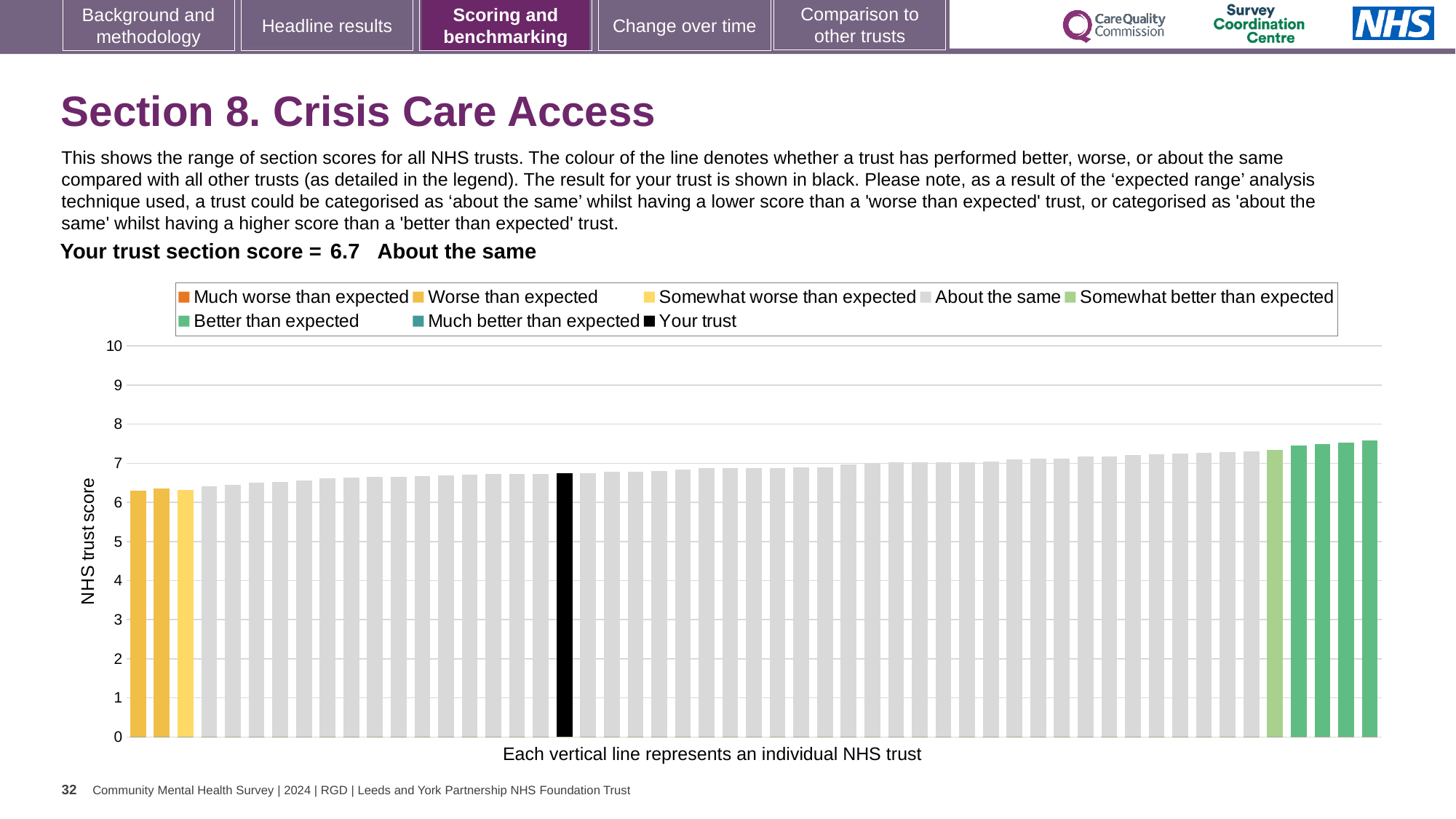
Is the value for the tallest bar on the chart greater or less than 7? greater How many entries does the chart legend list? 8 What is the label on the vertical axis of the chart? NHS trust score Is the value for the shortest bar on the chart greater or less than 6? greater What kind of chart is shown on the slide? bar chart Is the value for your trust (the black bar) greater or less than 7? less What is the section score for your trust shown on the slide? 6.7 How many bars are coloured as 'Worse than expected' (gold) on the chart? 2 Do the bar values rise or fall from left to right across the chart? rise Which performance category is your trust's section score assigned to? About the same Which is larger, the leftmost bar or the rightmost bar? the rightmost bar How many bars are coloured as 'Better than expected' (green) on the chart? 4